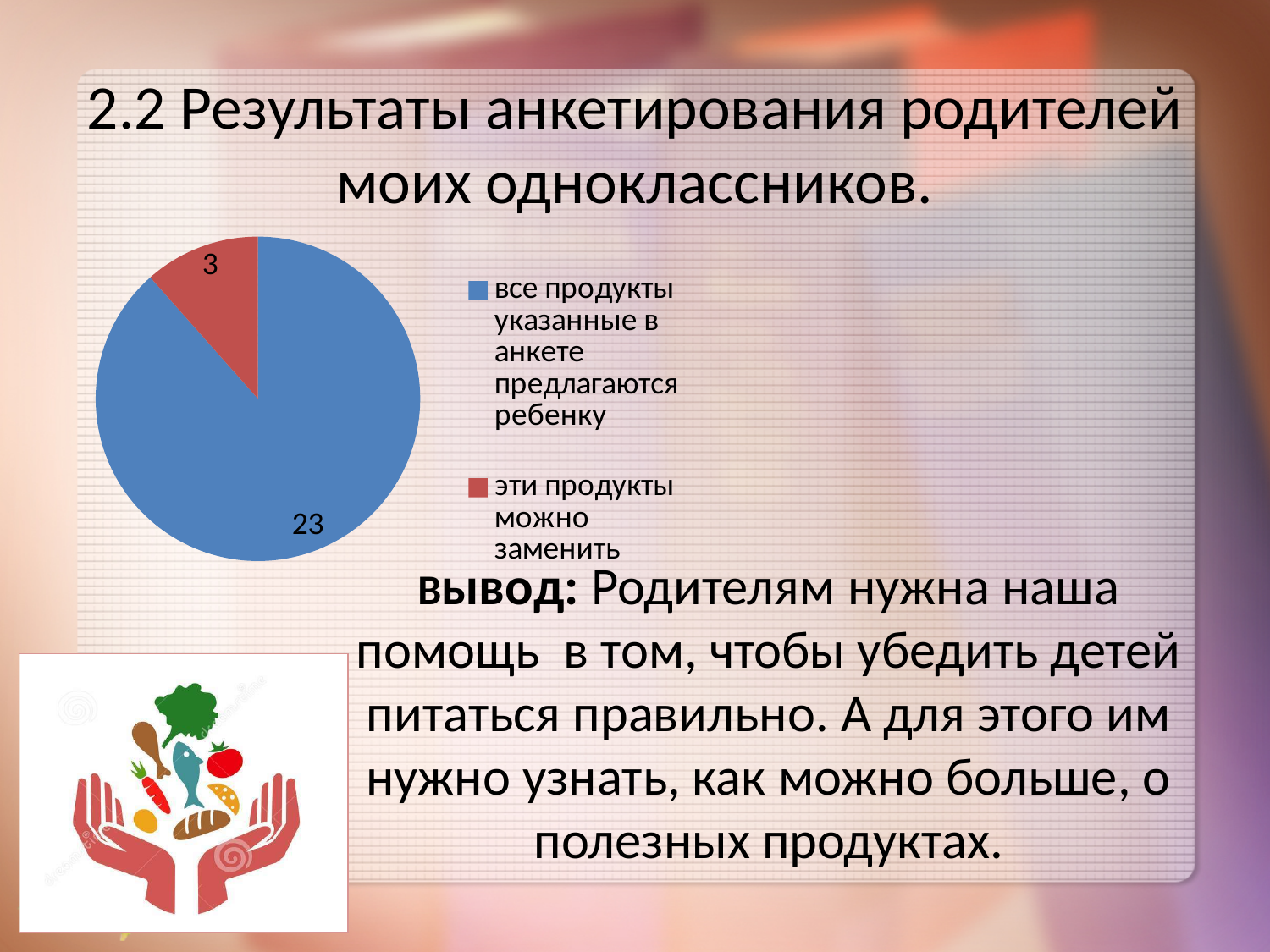
What is the value for the slice labelled "все продукты указанные в анкете предлагаются ребенку"? 23 What is the total of the two values shown in the pie chart? 26 What colour is the slice for "эти продукты можно заменить"? red What is the value for the slice labelled "эти продукты можно заменить"? 3 Which category has the smallest slice of the pie? эти продукты можно заменить Which is larger: the slice for "все продукты указанные в анкете предлагаются ребенку" or the slice for "эти продукты можно заменить"? все продукты указанные в анкете предлагаются ребенку Which category has the largest slice of the pie? все продукты указанные в анкете предлагаются ребенку How many entries does the legend list? 2 What is the difference between the two slice values in the pie chart? 20 What kind of chart is shown on the slide? pie chart How many slices does the pie chart have? 2 What colour is the slice for "все продукты указанные в анкете предлагаются ребенку"? blue